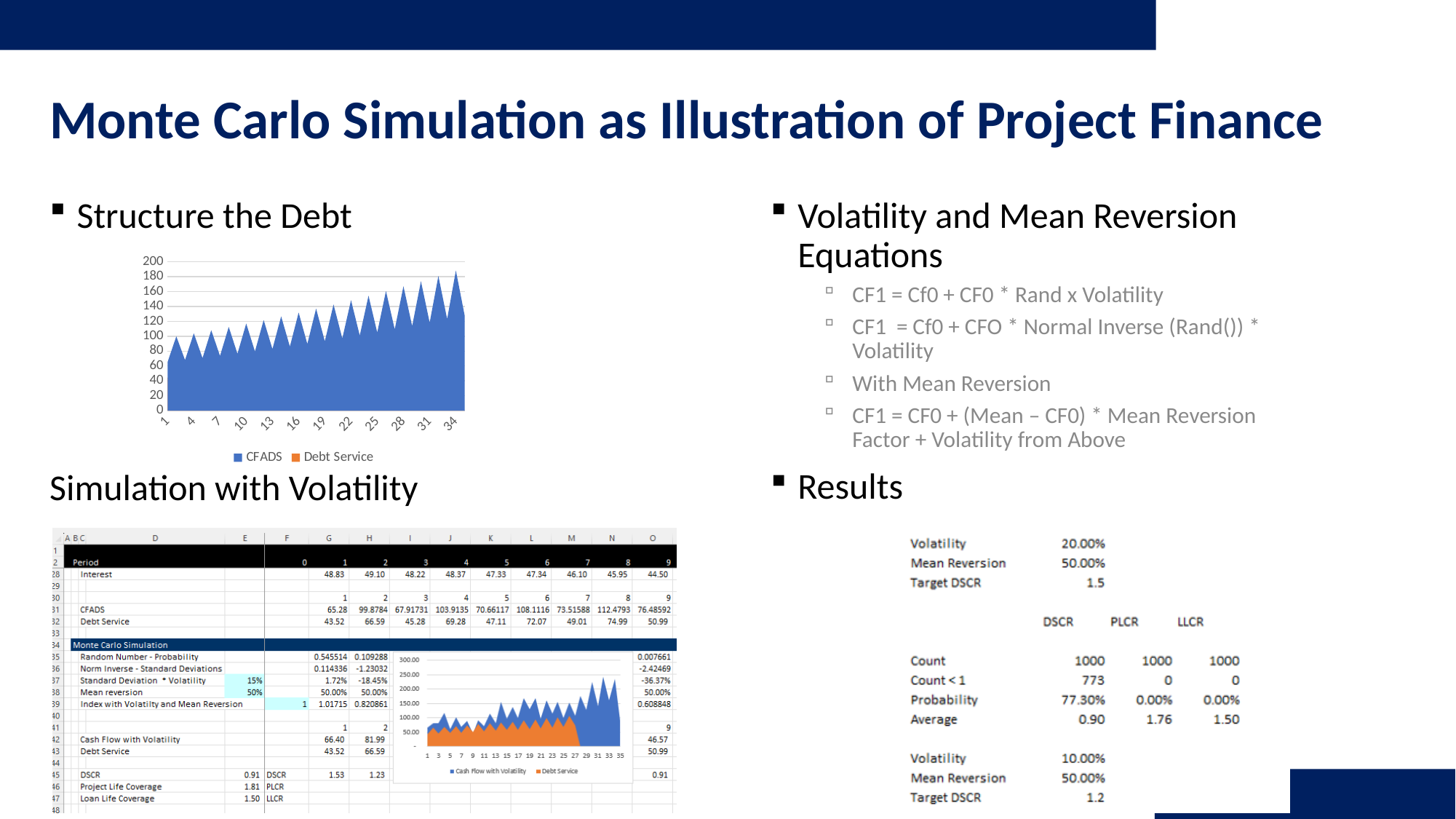
In the chart embedded in the 'Simulation with Volatility' spreadsheet, do the Cash Flow with Volatility values generally rise or fall along the x axis? rise In the 'Structure the Debt' chart, is the highest CFADS peak near period 34 greater or less than 160? greater In the 'Structure the Debt' chart, do the CFADS values generally rise or fall along the x axis? rise What are the two legend entries of the 'Structure the Debt' chart? CFADS and Debt Service In the chart embedded in the 'Simulation with Volatility' spreadsheet, is the highest Cash Flow with Volatility peak near the end greater or less than 200.00? greater In the 'Structure the Debt' chart, is the CFADS value at period 1 greater or less than 140? less What kind of chart is embedded in the spreadsheet screenshot under 'Simulation with Volatility'? area chart How many series does the legend of the 'Structure the Debt' chart list? 2 What is the maximum value shown on the y axis of the 'Structure the Debt' chart? 200 What kind of chart is shown under the heading 'Structure the Debt'? area chart How many series does the legend of the chart embedded in the 'Simulation with Volatility' spreadsheet list? 2